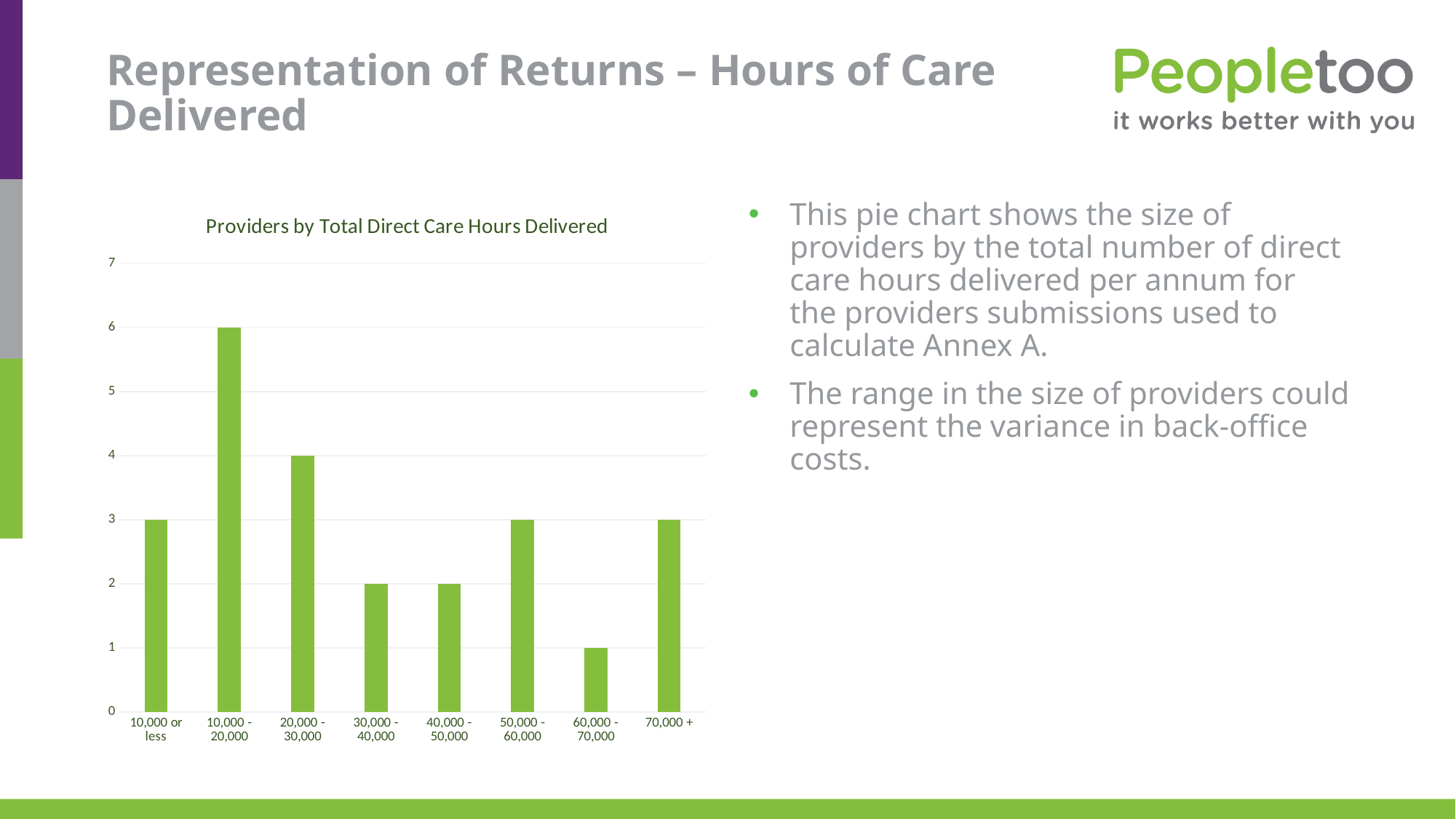
How many providers are in the 70,000 + category? 3 Is the value for the 10,000 - 20,000 category greater or less than 5? greater What type of chart is shown on the slide? bar chart What is the difference between the number of providers in the 10,000 - 20,000 category and the 60,000 - 70,000 category? 5 Which category has the highest number of providers? 10,000 - 20,000 What colour are the bars in the chart? green How many providers are in the 20,000 - 30,000 category? 4 Which category has the lowest number of providers? 60,000 - 70,000 Which has more providers, the 20,000 - 30,000 category or the 30,000 - 40,000 category? 20,000 - 30,000 What is the title of the chart? Providers by Total Direct Care Hours Delivered How many providers are in the 10,000 - 20,000 category? 6 How many categories are shown on the x axis of the chart? 8